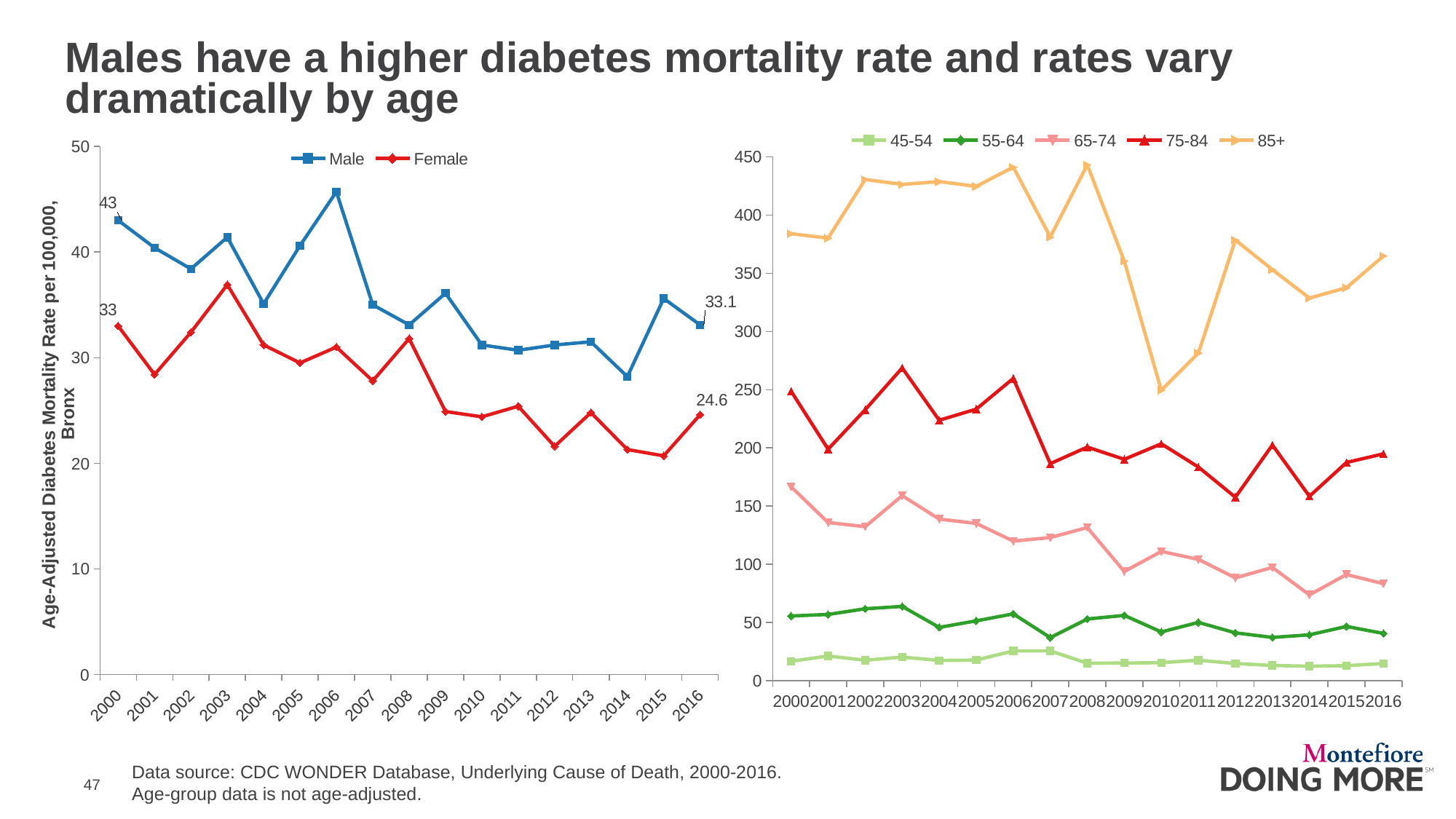
On the left chart, in which year is the Male rate highest? 2006 On the left chart, what is the Male diabetes mortality rate in 2000? 43 On the left chart, what is the difference between the Male and Female rates in 2000? 10 On the left chart, how many years are shown on the x axis? 17 On the left chart, is the Male value for 2006 greater or less than 40? greater What kind of chart is the left chart? Line chart On the left chart, what is the difference between the Male and Female rates in 2016? 8.5 On the left chart, how many series does the legend list? 2 On the right chart, which age group has the highest mortality rates? 85+ On the left chart, what is the Female diabetes mortality rate in 2016? 24.6 On the right chart, how many age groups does the legend list? 5 On the right chart, is the value for the 85+ group in 2010 greater or less than 300? less